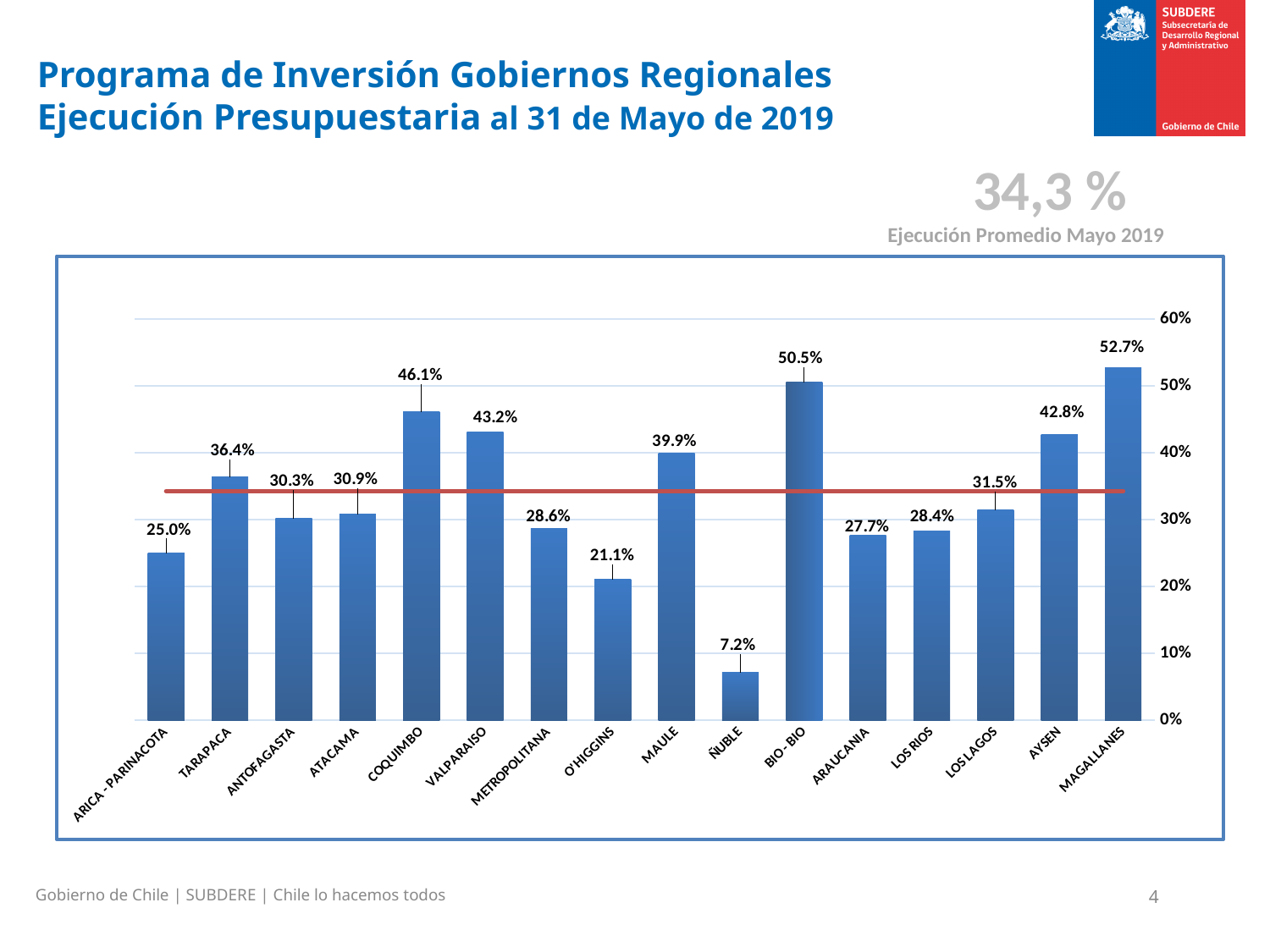
What is the value for LOS LAGOS? 31.5% What is the value for ÑUBLE? 7.2% Which is larger, the value for VALPARAISO or the value for AYSEN? VALPARAISO What kind of chart is shown on the slide? Bar chart with a horizontal line marking the average (combination bar and line chart) What average execution value does the slide report for May 2019? 34,3 % What is the difference between the values for BIO-BIO and MAULE? 10.6 percentage points What is the value for COQUIMBO? 46.1% How many regions are shown on the x axis? 16 What is the difference between the values for MAGALLANES and ARICA - PARINACOTA? 27.7 percentage points Is the value for O'HIGGINS greater or less than 30%? less Which region has the lowest value? ÑUBLE Which region has the highest value? MAGALLANES